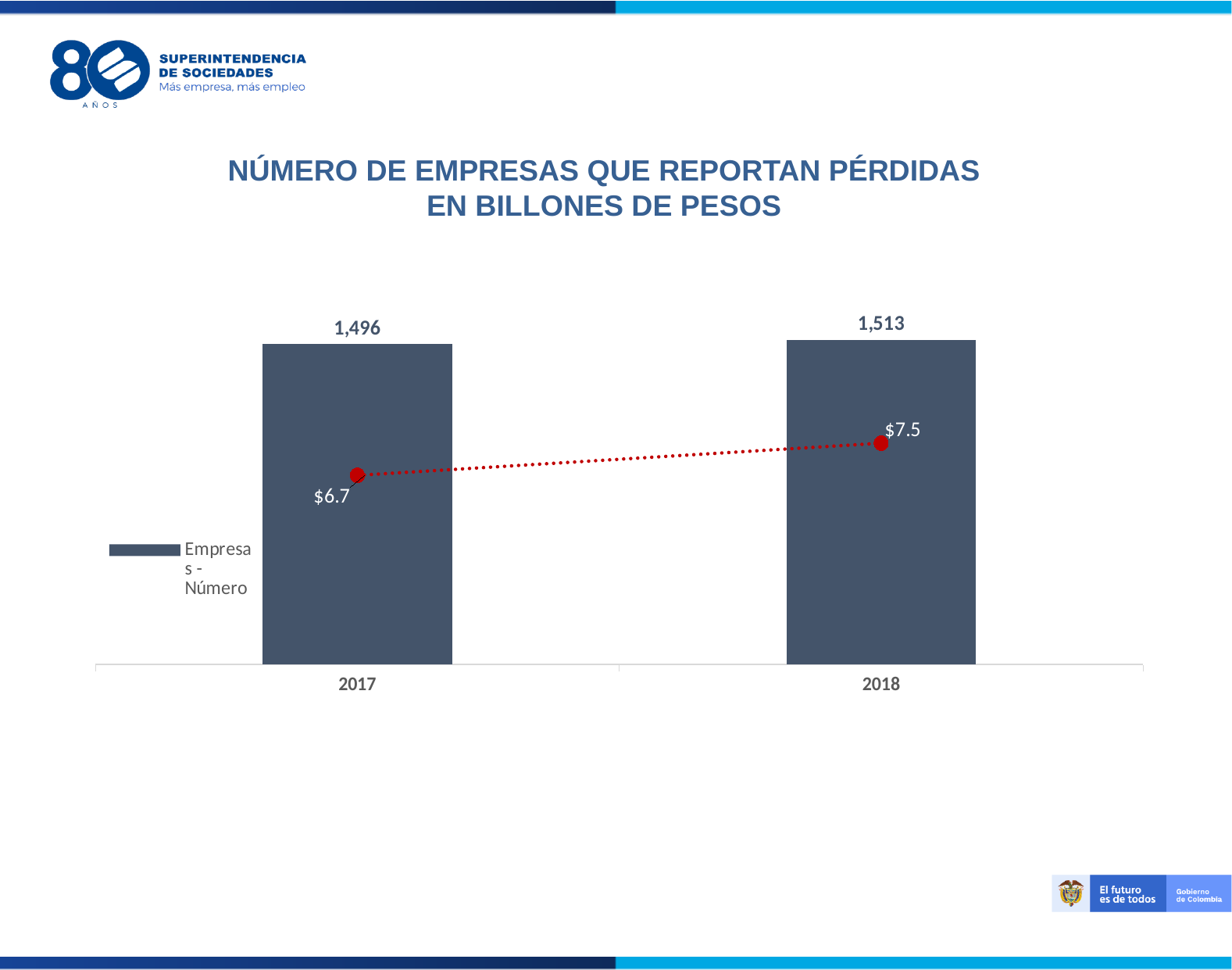
Is the red line value for 2018 larger or smaller than the value for 2017? larger What is the title of the chart? NÚMERO DE EMPRESAS QUE REPORTAN PÉRDIDAS EN BILLONES DE PESOS What value does the red line show for 2018? $7.5 By how much did the number of companies reporting losses increase from 2017 to 2018? 17 Do the values of the red line rise or fall from 2017 to 2018? rise What is the number of companies reporting losses in 2018? 1,513 How many years are shown on the x axis? 2 What value does the red line show for 2017? $6.7 What is the difference between the red line values for 2018 and 2017? $0.8 What is the number of companies reporting losses in 2017? 1,496 Which year has the higher number of companies reporting losses? 2018 Which year has the lower value on the red line? 2017